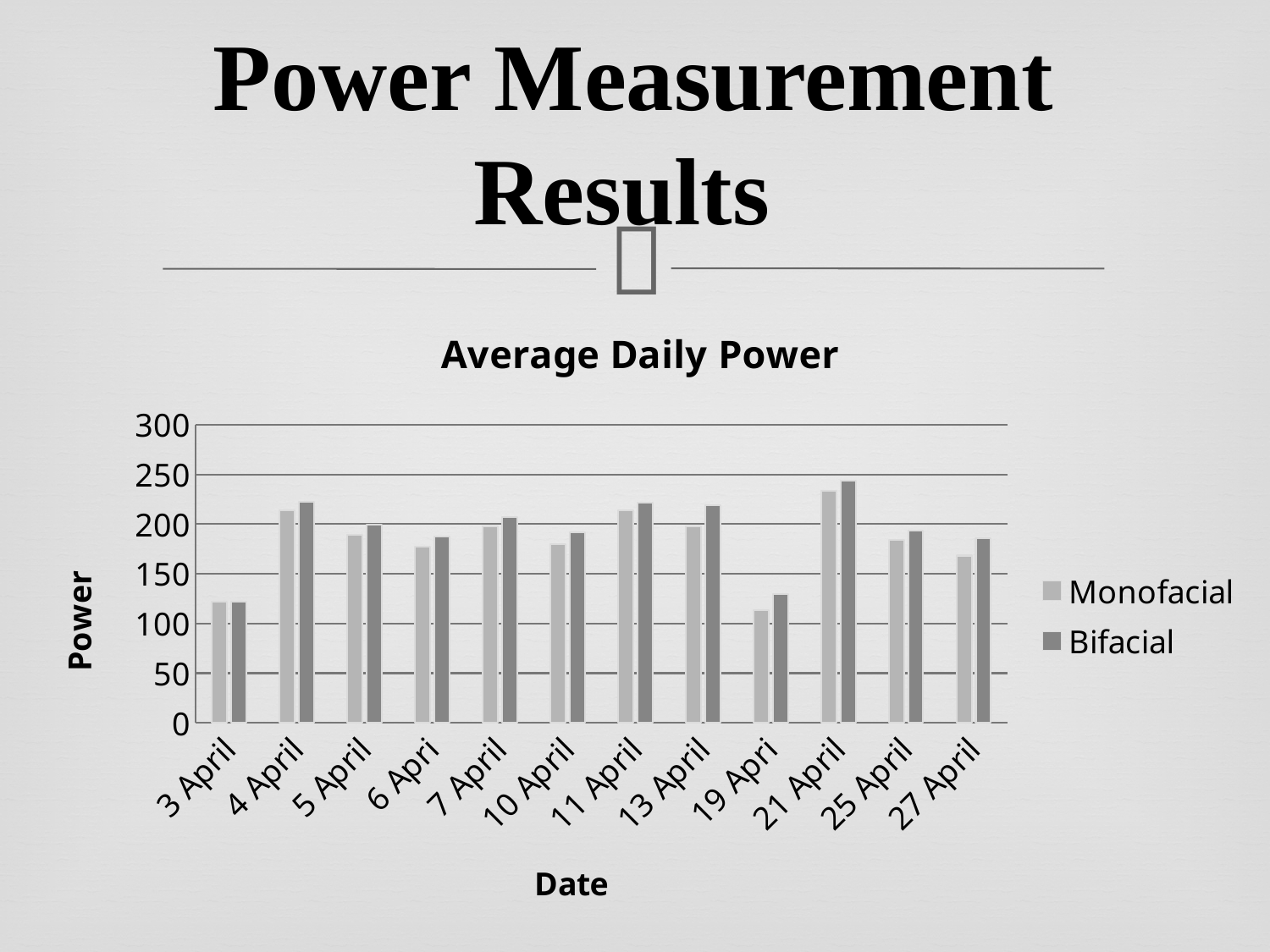
Is the Monofacial value for 3 April greater or less than 150? less How many series does the legend of the "Average Daily Power" chart list? 2 How many dates are shown on the x axis of the "Average Daily Power" chart? 12 Is the Bifacial value for 21 April greater or less than 200? greater What kind of chart is shown under the title "Average Daily Power"? bar chart On which date is the Bifacial value highest in the "Average Daily Power" chart? 21 April Is the Monofacial value for 27 April greater or less than 200? less Which is larger: the Bifacial value for 21 April or the Bifacial value for 19 Apri? 21 April On which date is the Monofacial value lowest in the "Average Daily Power" chart? 19 Apri Which is larger: the Monofacial value for 4 April or the Monofacial value for 6 Apri? 4 April What is the label of the y axis in the "Average Daily Power" chart? Power What is the label of the x axis in the "Average Daily Power" chart? Date